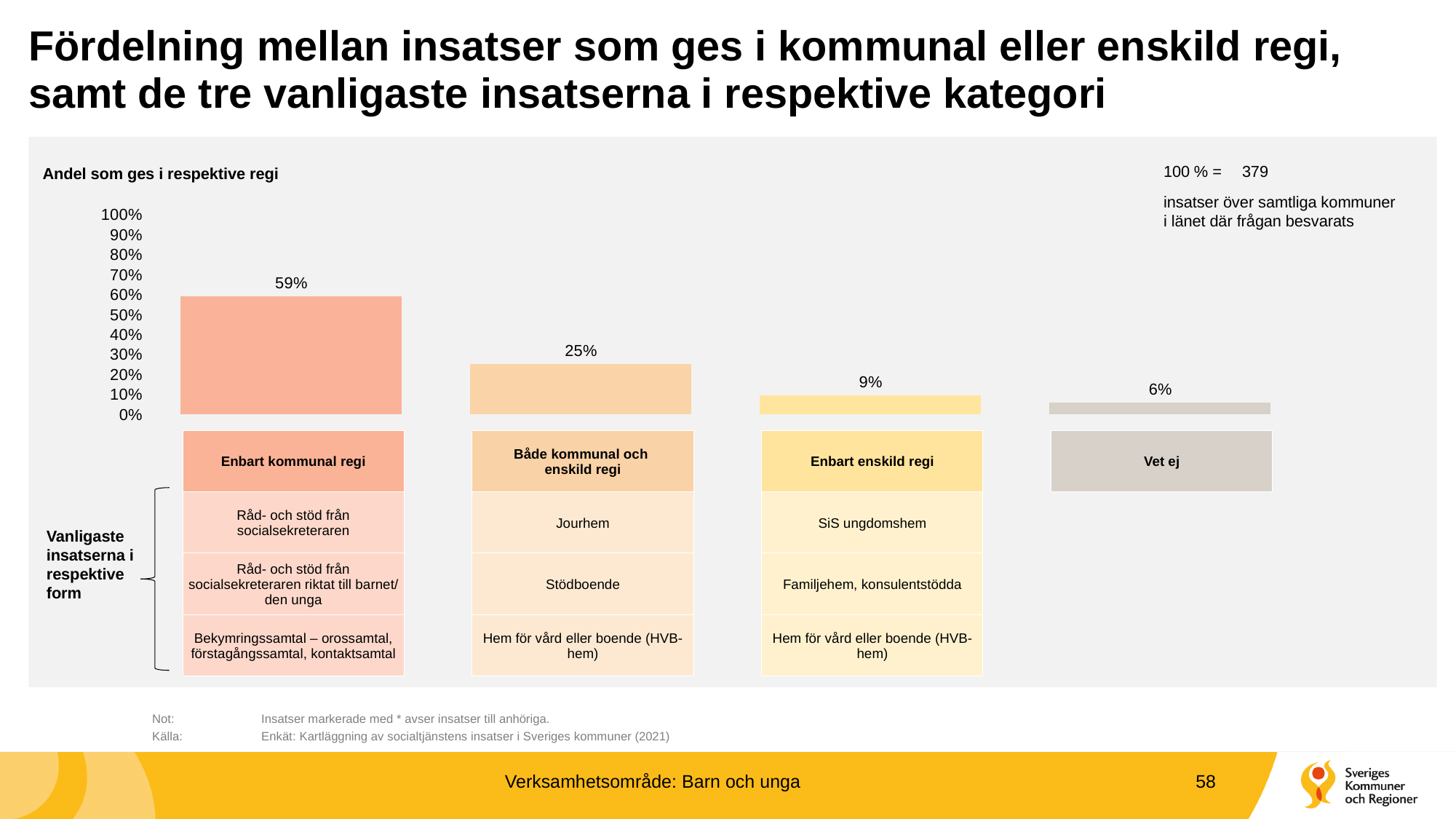
How many categories are shown in the chart? 4 Is the value for Enbart kommunal regi greater or less than 50%? greater Which category has the lowest value? Vet ej What kind of chart is shown on the slide? bar chart What number of insatser does 100% correspond to according to the note on the chart? 379 What is the value for Vet ej? 6% Which category has the highest value? Enbart kommunal regi What is the difference between the values for Enbart kommunal regi and Både kommunal och enskild regi? 34% What is the value for Enbart enskild regi? 9% Which is larger, the value for Enbart enskild regi or the value for Vet ej? Enbart enskild regi What is the value for Enbart kommunal regi? 59% What is the value for Både kommunal och enskild regi? 25%